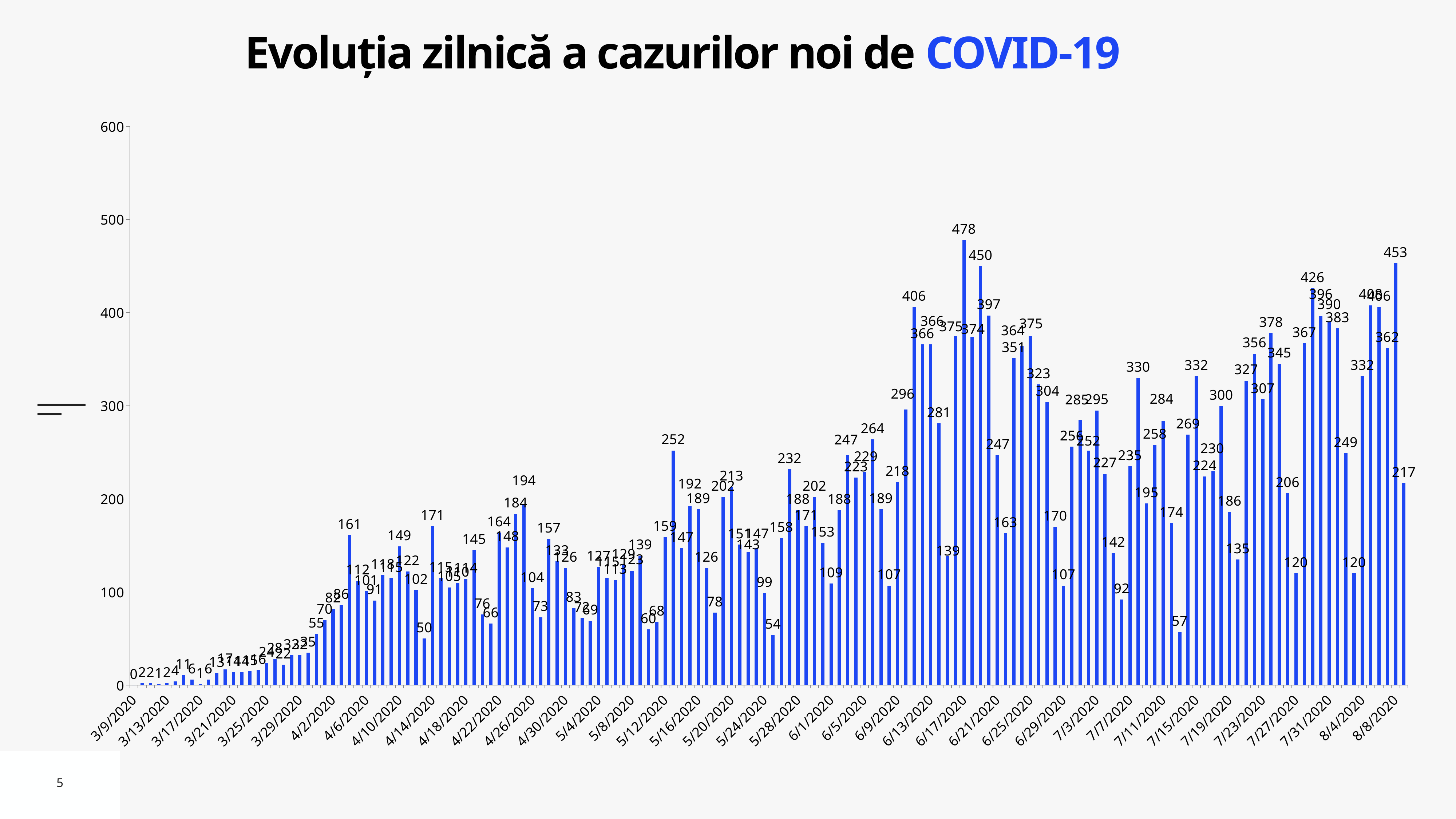
What is the highest daily value shown in the chart? 478 What is the value for 8/8/2020, the last date on the chart? 453 Is the value for 8/8/2020 greater or less than 200? greater What kind of chart is shown on the slide? bar chart Overall, do the daily values rise or fall from March to August along the x axis? rise What is the maximum value shown on the vertical axis? 600 What is the second highest daily value shown in the chart? 453 What is the lowest daily value shown in the chart? 0 What is the difference between the highest value (478) and the second highest value (453)? 25 What is the title of the chart? Evoluția zilnică a cazurilor noi de COVID-19 Which is larger, the value for 8/8/2020 or the value for 3/9/2020? 8/8/2020 What is the value for 3/9/2020, the first date on the chart? 0